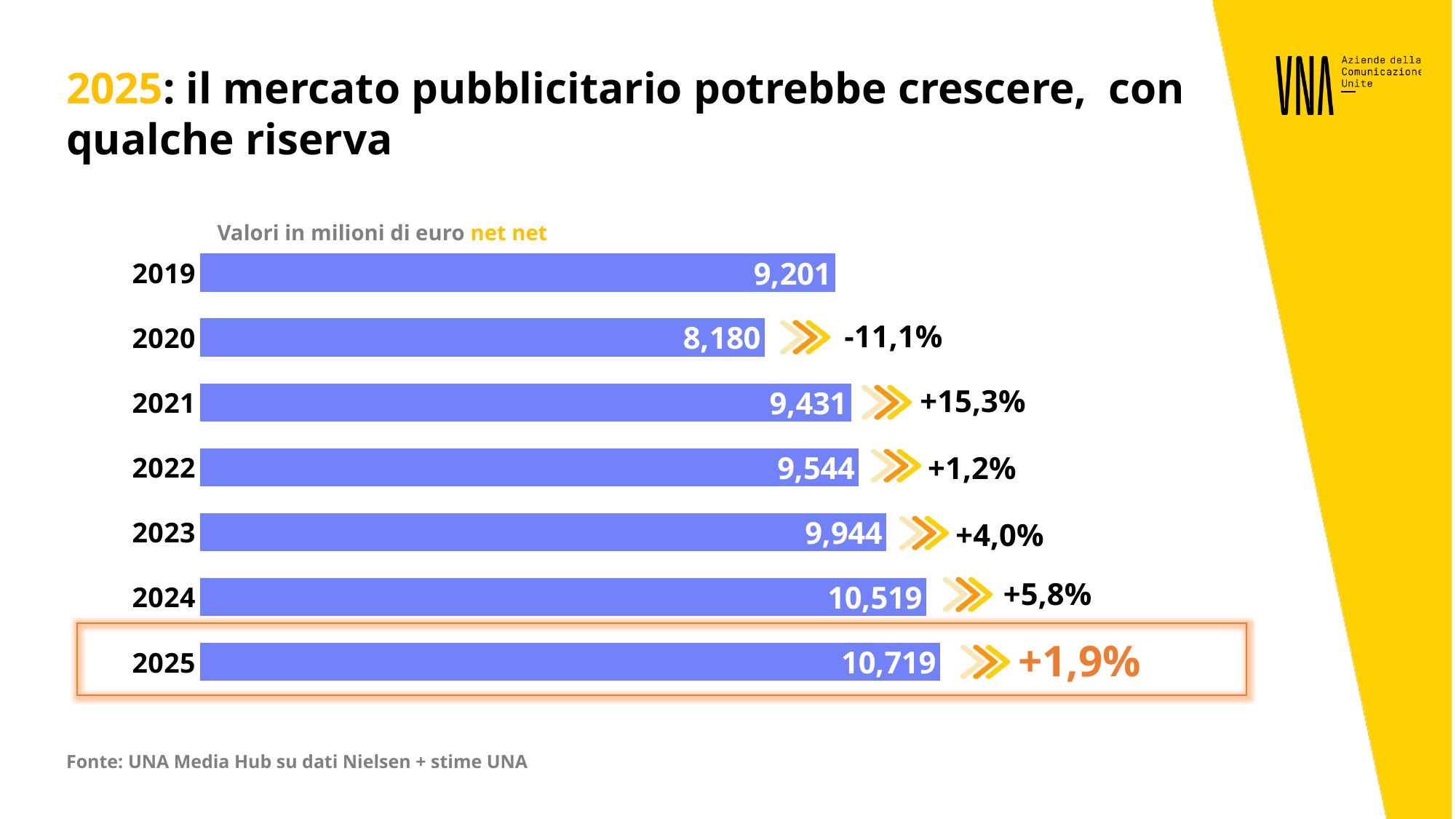
What kind of chart is shown on the slide? Bar chart Which is larger, the value for 2021 or the value for 2022? 2022 Which year has the highest value? 2025 Which year has the lowest value? 2020 What is the value for 2019? 9,201 What is the difference between the values for 2025 and 2024? 200 What percentage change is shown next to the 2021 bar? +15,3% What is the difference between the values for 2019 and 2020? 1,021 How many years are shown in the chart? 7 What percentage change is shown next to the 2020 bar? -11,1% Do the values rise or fall from 2020 to 2025? Rise What is the value for 2025? 10,719